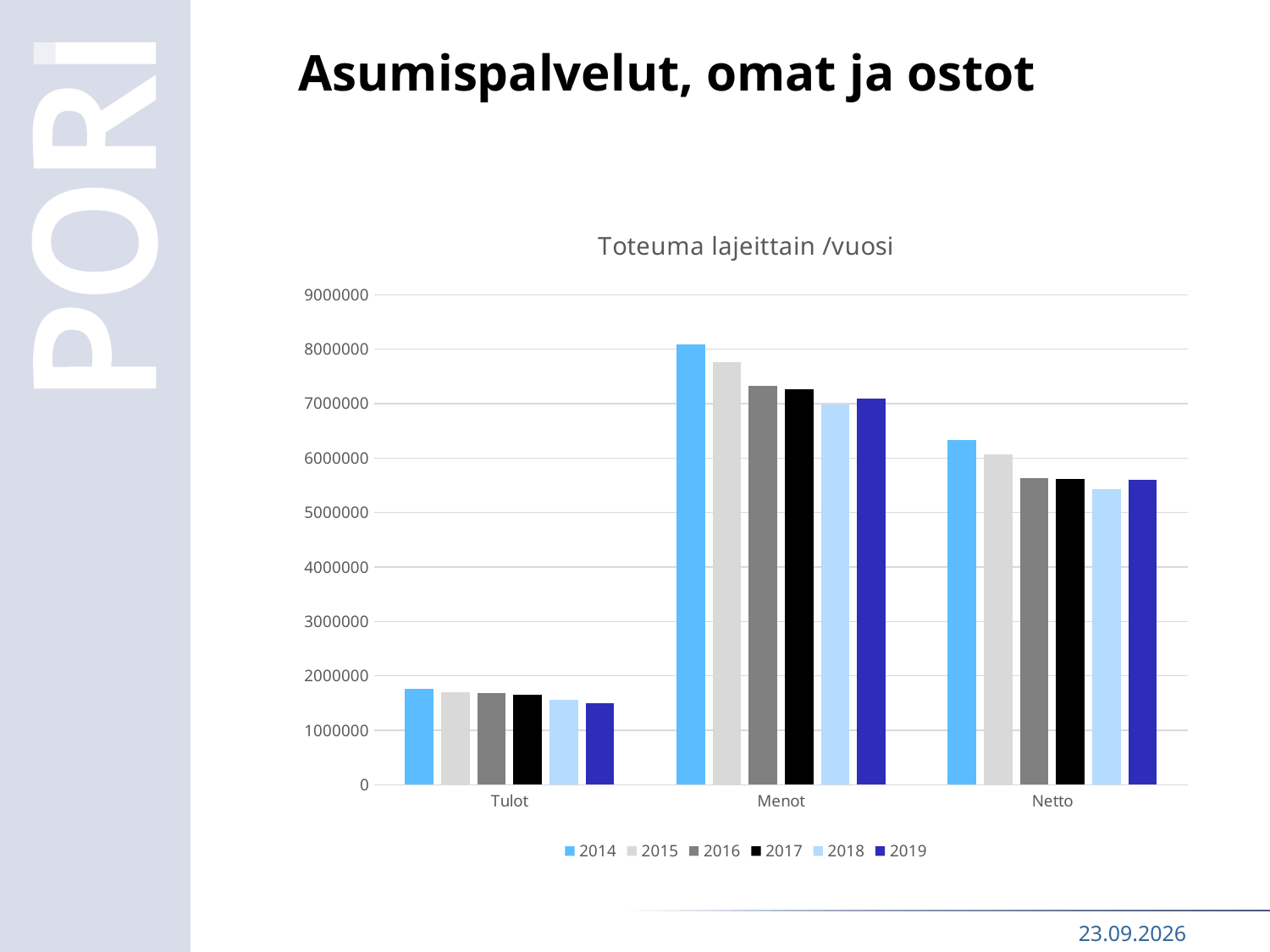
Is the value for Netto in 2018 greater or less than 6000000? less How many series does the legend list? 6 What is the title of the chart? Toteuma lajeittain /vuosi Within the Tulot category, which year has the lowest value? 2019 How many categories are shown on the x axis? 3 Within the Netto category, which year has the highest value? 2014 Within the Menot category, which year has the highest value? 2014 Is the value for Menot in 2014 greater or less than 7000000? greater Which is larger for 2014: Menot or Netto? Menot Is the value for Tulot in 2014 greater or less than 2000000? less Do the Tulot values rise or fall from 2014 to 2019? fall What kind of chart is shown on the slide? bar chart